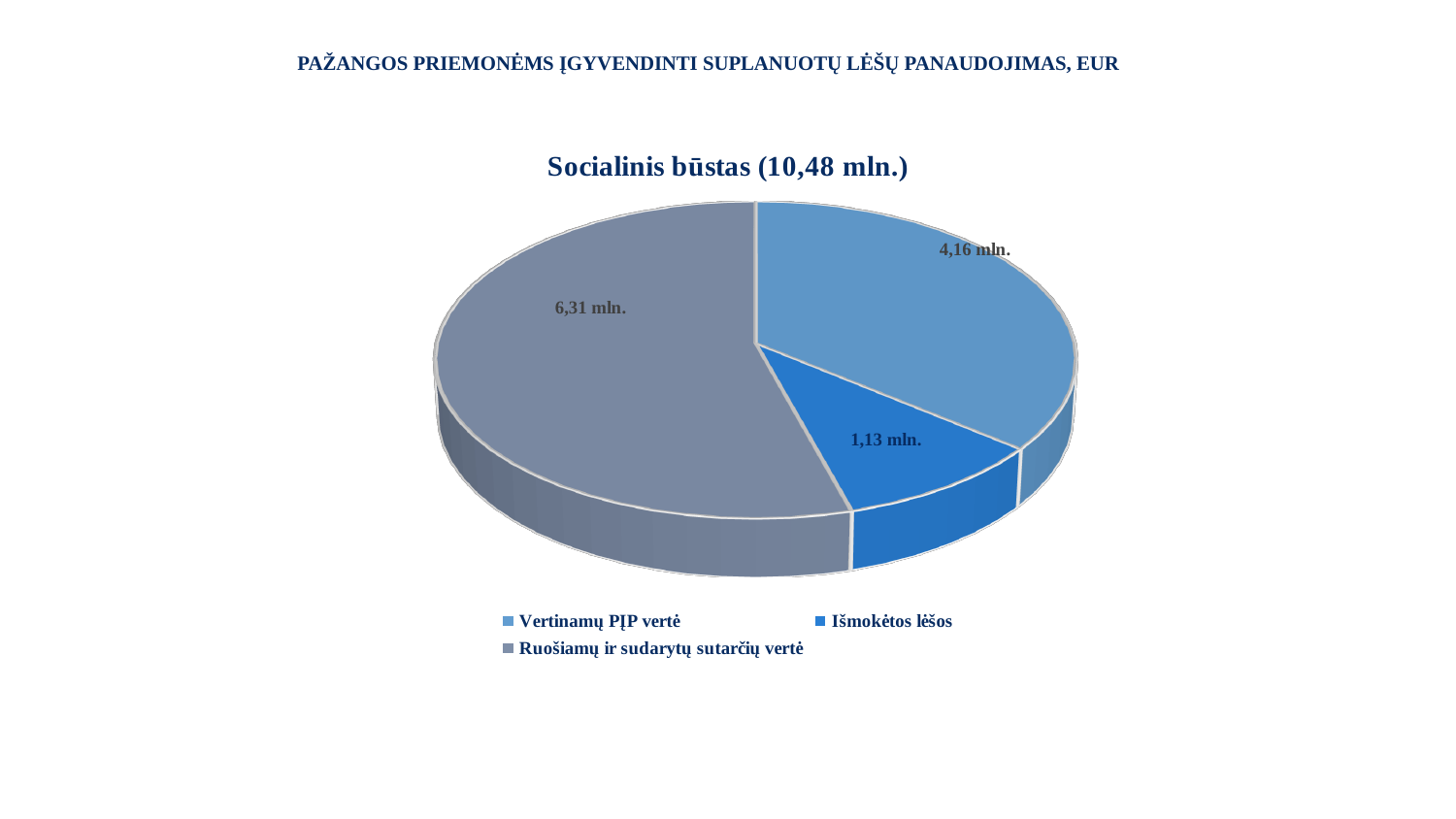
Which is larger, Vertinamų PĮP vertė or Išmokėtos lėšos? Vertinamų PĮP vertė What is the value for Vertinamų PĮP vertė? 4,16 mln. What is the difference between Vertinamų PĮP vertė and Išmokėtos lėšos? 3,03 mln. What type of chart is shown on the slide? pie chart Which category has the largest slice? Ruošiamų ir sudarytų sutarčių vertė What is the difference between Ruošiamų ir sudarytų sutarčių vertė and Vertinamų PĮP vertė? 2,15 mln. What is the title of the chart? Socialinis būstas (10,48 mln.) How many slices does the pie chart have? 3 Which category has the smallest slice? Išmokėtos lėšos What is the value for Išmokėtos lėšos? 1,13 mln. How many entries does the legend list? 3 What is the value for Ruošiamų ir sudarytų sutarčių vertė? 6,31 mln.